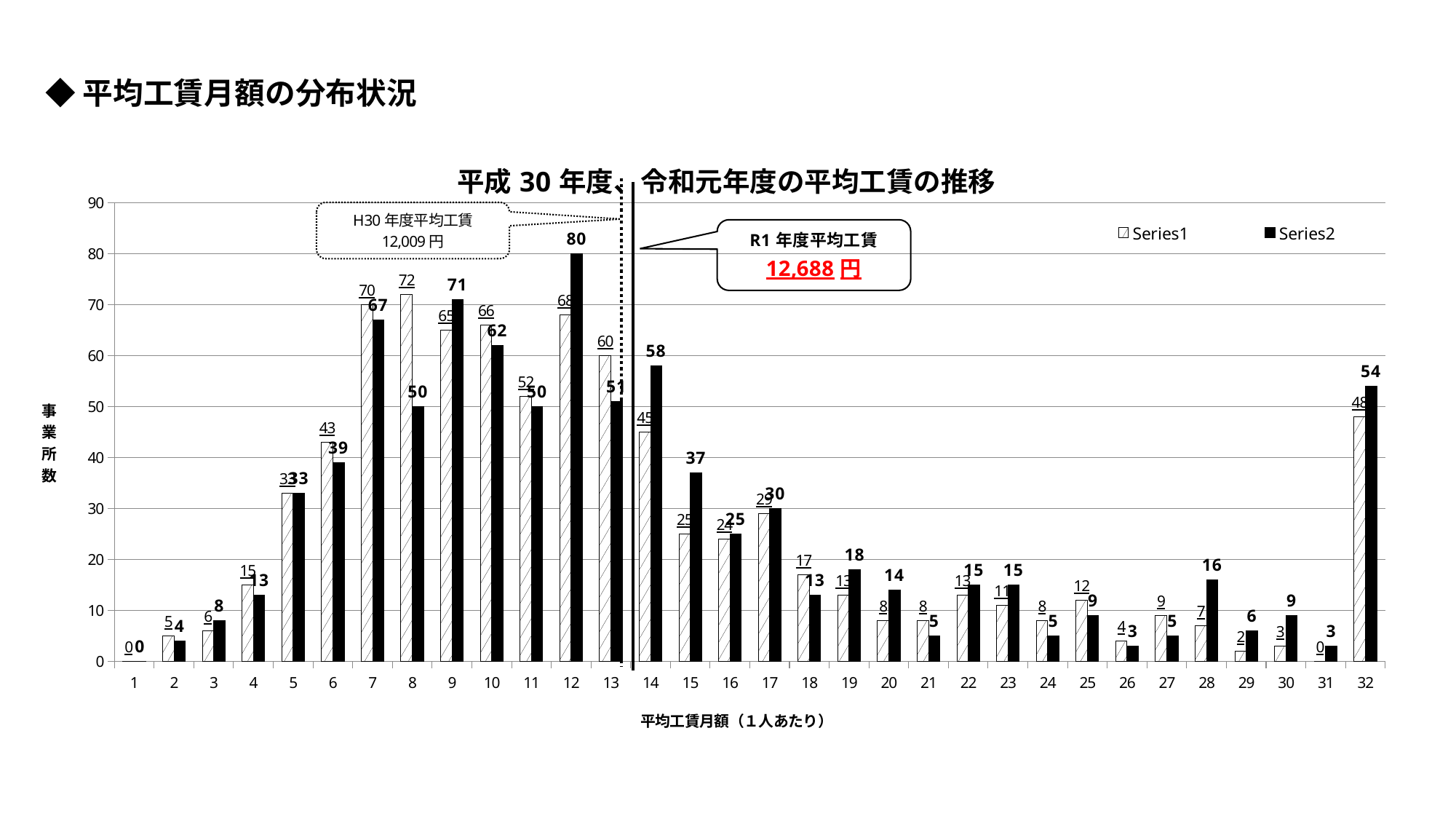
How many categories are shown on the x axis? 32 What is the Series1 value for category 8? 72 What kind of chart is shown? Bar chart What is the R1 年度平均工賃 value shown in the callout on the chart? 12,688 円 Which category has the highest Series1 value? 8 What is the Series2 value for category 32? 54 How many series does the legend list? 2 What is the Series2 value for category 12? 80 For category 28, which is larger, Series1 or Series2? Series2 Which category has the highest Series2 value? 12 For category 8, which is larger, Series1 or Series2? Series1 What is the difference between the Series2 and Series1 values for category 14? 13